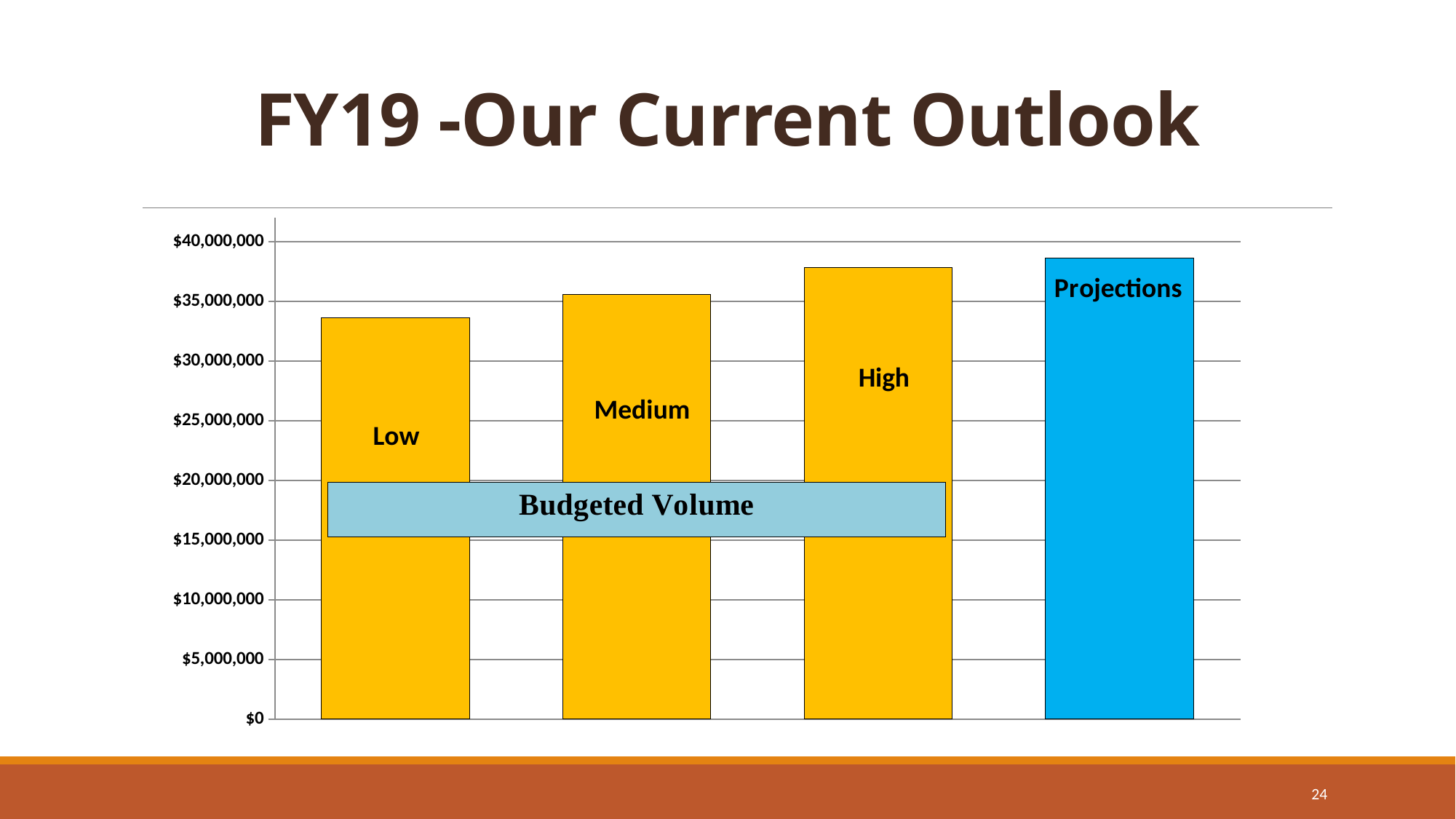
Which bar is the tallest in the chart? Projections Which bar is the shortest in the chart? Low What kind of chart is shown on the slide? bar chart How many bars are plotted in the chart? 4 Do the bar values rise or fall from left to right across the chart? rise What label is written on the light blue horizontal band across the Low, Medium and High bars? Budgeted Volume Is the value for Low greater or less than $35,000,000? less Is the value for High greater or less than $35,000,000? greater Is the value for Low greater or less than $30,000,000? greater What is the title of the slide containing the chart? FY19 -Our Current Outlook Which is larger, the value for High or the value for Low? High